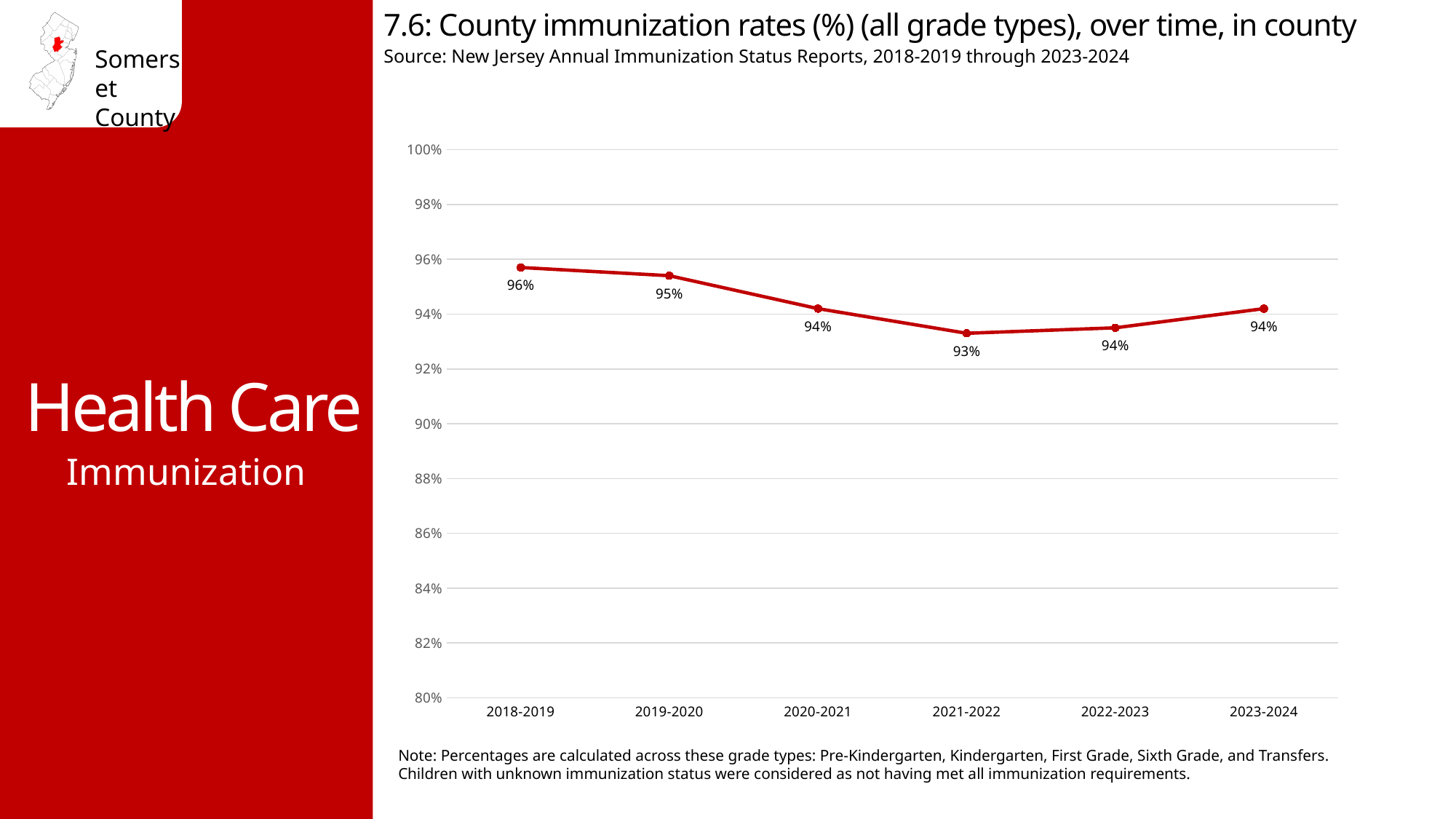
What is the county immunization rate for 2021-2022? 93% How many school years are plotted on the chart? 6 Which is larger, the immunization rate in 2018-2019 or in 2021-2022? 2018-2019 Does the immunization rate rise or fall from 2018-2019 to 2021-2022? Fall Which school year has the highest immunization rate? 2018-2019 What is the difference between the immunization rate in 2018-2019 and in 2021-2022, based on the data labels? 3% Is the immunization rate for 2021-2022 greater or less than 90%? greater Which school year has the lowest immunization rate? 2021-2022 What kind of chart is shown on the slide? Line chart What is the county immunization rate for 2019-2020? 95% What is the county immunization rate for 2018-2019? 96% What is the county immunization rate for 2023-2024? 94%